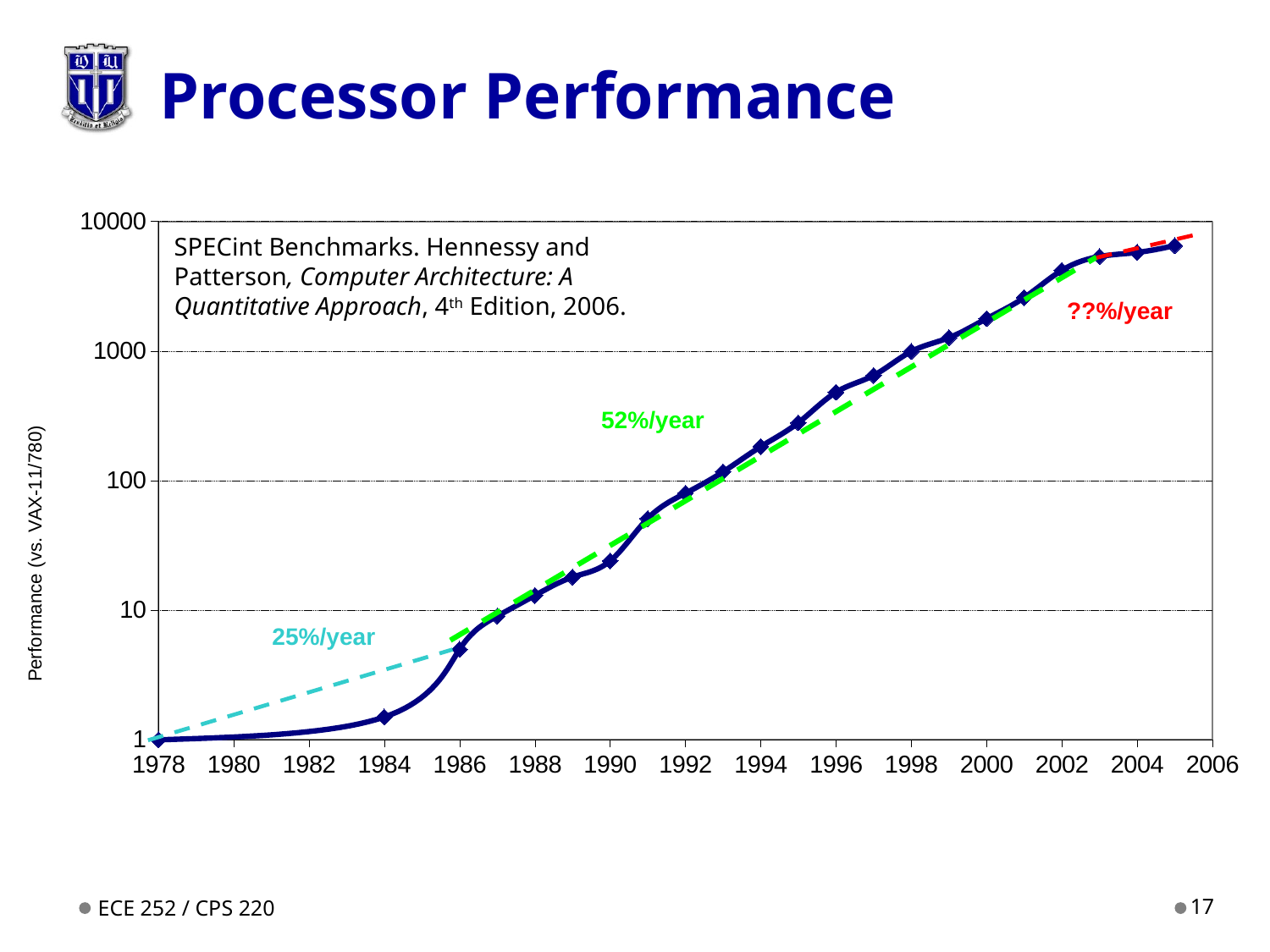
Do the plotted performance values rise or fall from 1978 to 2005? rise Is the performance value for 1990 greater or less than 10? greater Is the performance value for 1996 greater or less than 1000? less What is the plotted performance value for 1978? 1 Which year has the larger performance value, 1998 or 1990? 1998 Which year has the lowest plotted performance value? 1978 What annual growth rate is labelled on the green dashed trend line? 52%/year What is the label on the y axis? Performance (vs. VAX-11/780) Is the performance value for 1984 greater or less than 10? less What kind of chart is shown on the slide? line chart Which year has the highest plotted performance value? 2005